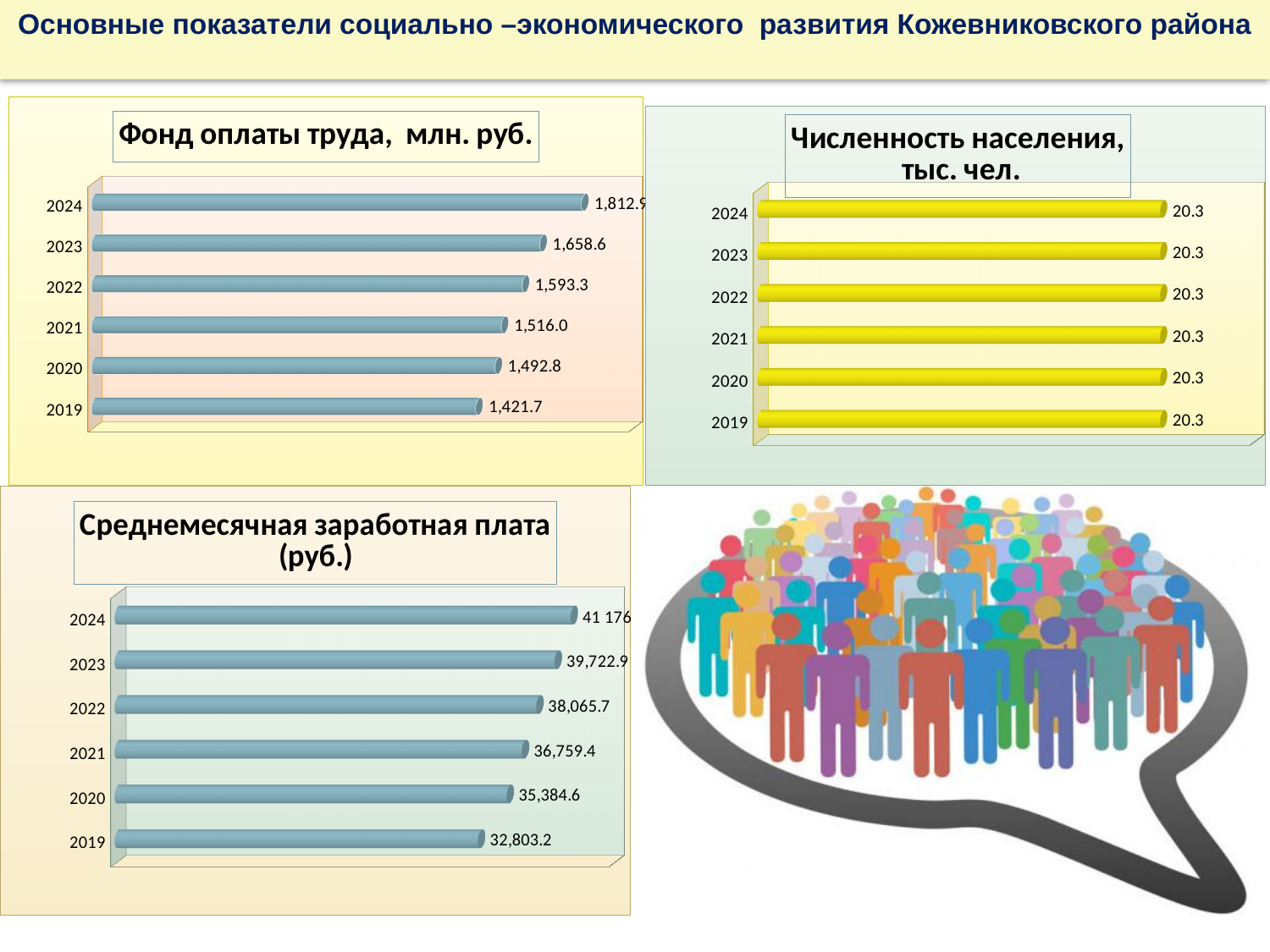
In the chart 'Среднемесячная заработная плата (руб.)', what is the value for 2020? 35,384.6 What type of chart is 'Численность населения, тыс. чел.'? bar chart In the chart 'Численность населения, тыс. чел.', what is the value for 2022? 20.3 In the chart 'Фонд оплаты труда, млн. руб.', what is the value for 2023? 1,658.6 In the chart 'Среднемесячная заработная плата (руб.)', what is the value for 2024? 41 176 In the chart 'Фонд оплаты труда, млн. руб.', what is the difference between the values for 2021 and 2020? 23.2 In the chart 'Фонд оплаты труда, млн. руб.', which year has the highest value? 2024 In the chart 'Фонд оплаты труда, млн. руб.', which year has the lowest value? 2019 In the chart 'Среднемесячная заработная плата (руб.)', do the values rise or fall from 2019 to 2024? rise In the chart 'Фонд оплаты труда, млн. руб.', what is the value for 2019? 1,421.7 How many years are shown in the chart 'Численность населения, тыс. чел.'? 6 In the chart 'Среднемесячная заработная плата (руб.)', which is larger, the value for 2022 or the value for 2021? 2022